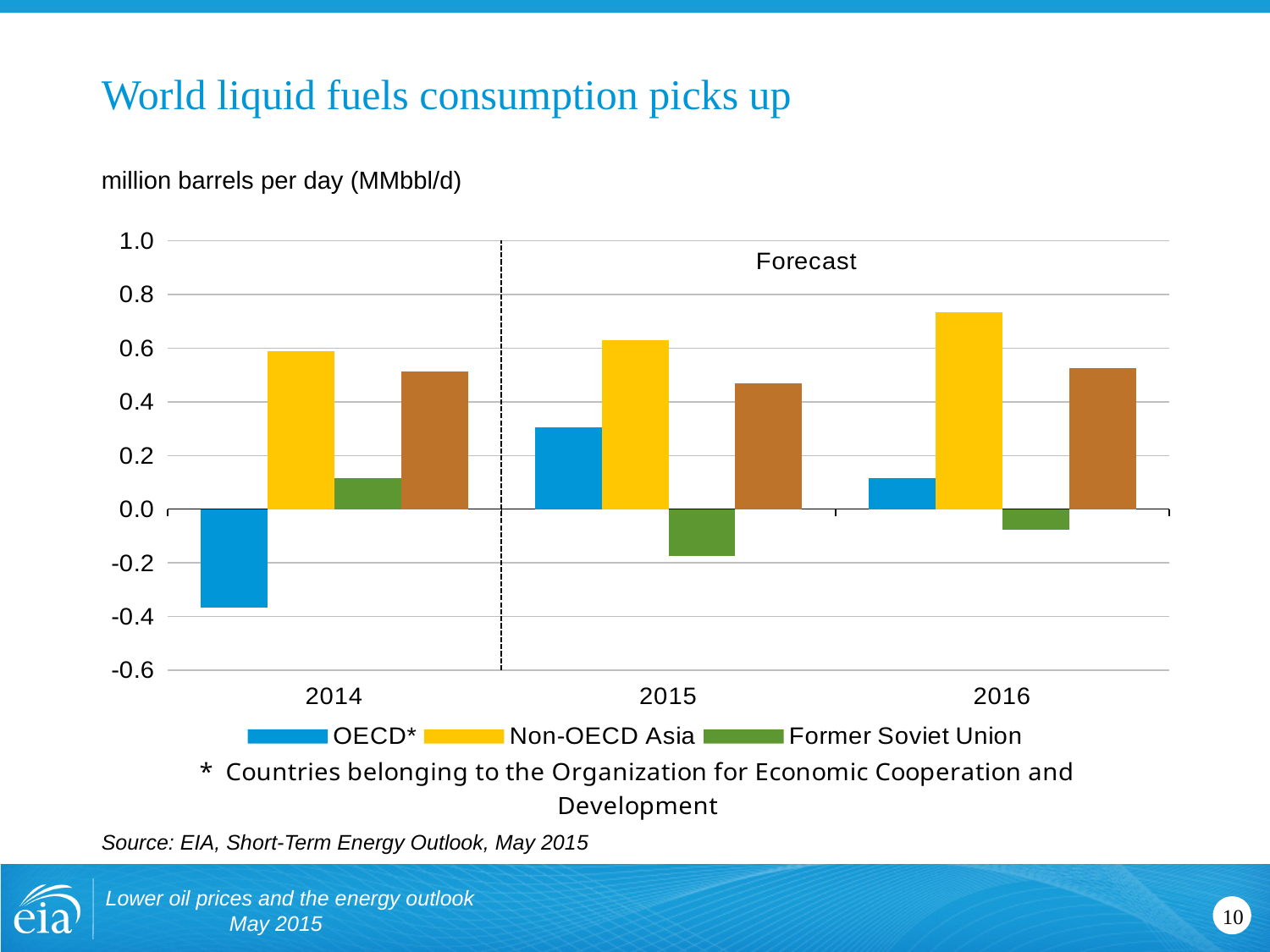
Do the Non-OECD Asia values rise or fall from 2014 to 2016? rise Is the value for OECD* in 2015 greater or less than 0.2? greater Which is larger, the OECD* value in 2015 or in 2016? 2015 Is the value for Former Soviet Union in 2015 greater or less than 0.0? less Which years on the chart are marked as forecast? 2015 and 2016 Which year has the lowest value for OECD*? 2014 Is the value for Non-OECD Asia in 2016 greater or less than 0.6? greater How many series does the legend list? 3 What kind of chart is shown on the slide? bar chart How many years are shown on the x axis? 3 Which year has the highest value for Non-OECD Asia? 2016